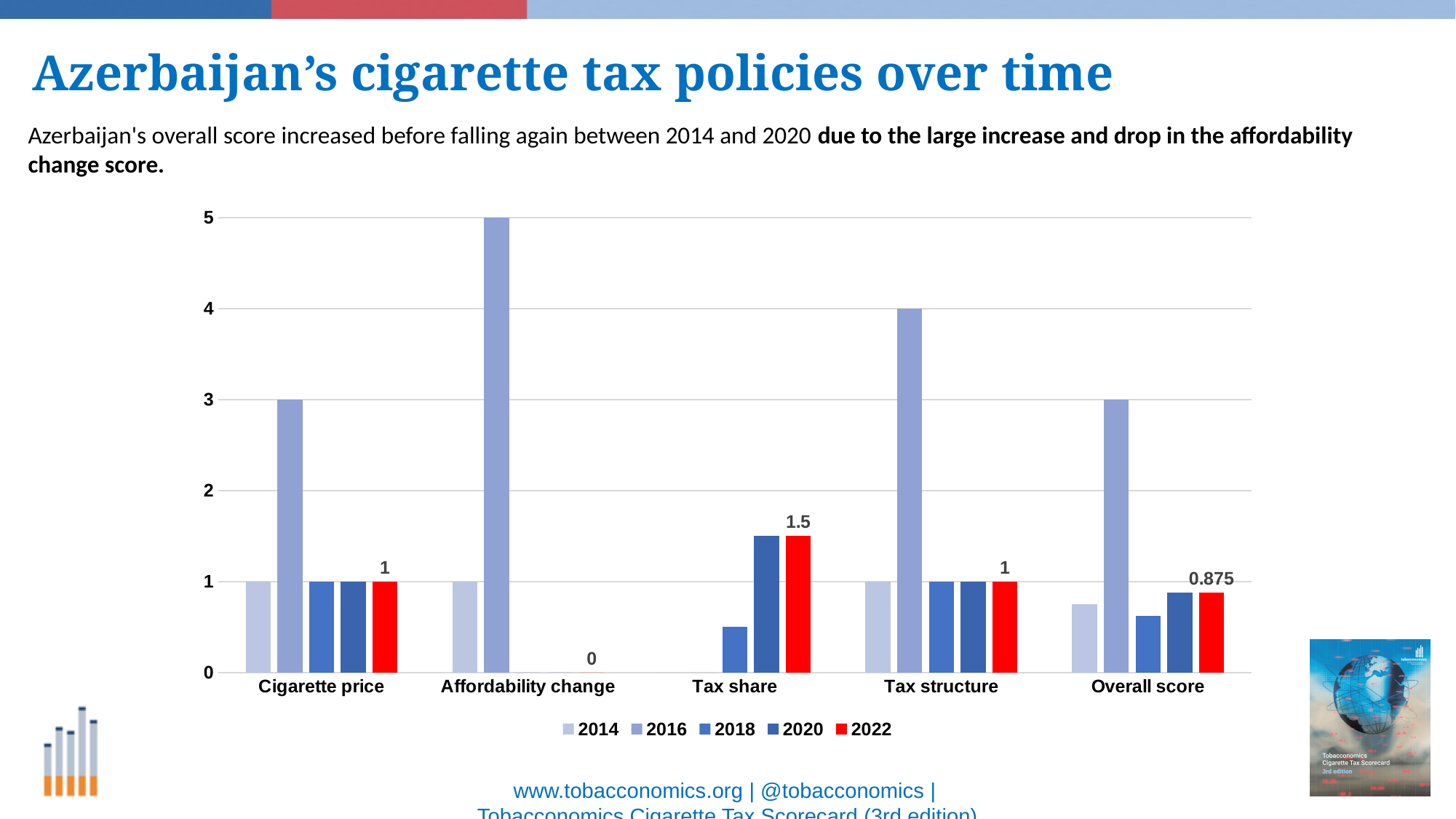
What is the 2022 value for Overall score? 0.875 How many categories are shown on the x axis? 5 Is the 2018 value for Tax share greater or less than 1? less What is the 2022 value for Tax share? 1.5 What is the difference between the 2022 value for Tax share and the 2022 value for Overall score? 0.625 Which category has the lowest 2022 value? Affordability change How many series does the legend list? 5 What kind of chart is shown on the slide? bar chart What is the 2016 value for Affordability change? 5 Which is larger, the 2016 value for Tax structure or the 2016 value for Cigarette price? Tax structure Which category has the highest 2016 value? Affordability change What is the 2022 value for Affordability change? 0